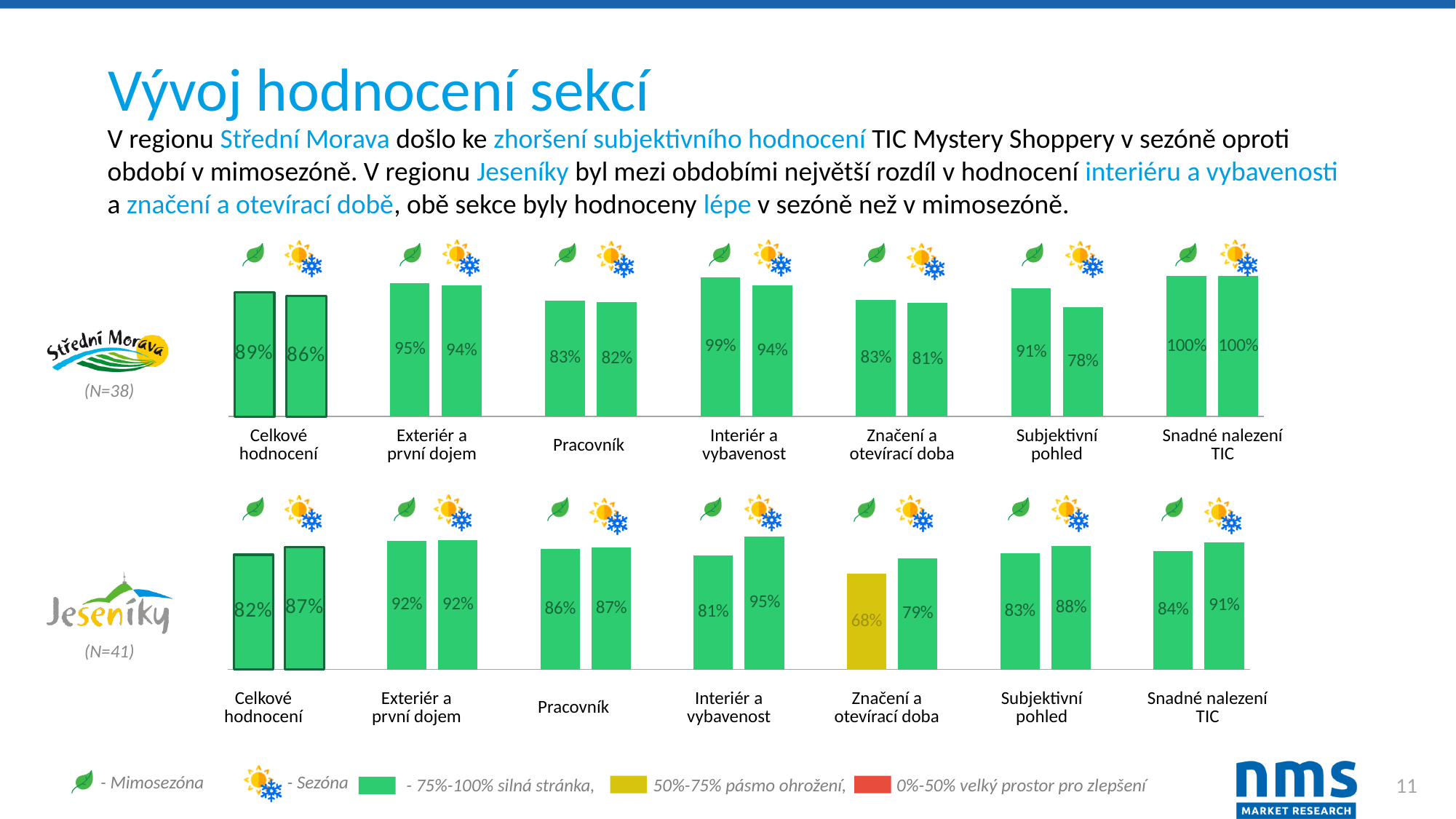
How many categories are shown in the Střední Morava chart? 7 What type of chart is used for the Jeseníky region? bar chart In the Jeseníky chart, what is the difference between the Sezóna and Mimosezóna values for Interiér a vybavenost? 14% In the Jeseníky chart, which category has the highest Sezóna value? Interiér a vybavenost In the Jeseníky chart, what is the Sezóna value for Snadné nalezení TIC? 91% In the Jeseníky chart, which bar is coloured yellow instead of green? Mimosezóna for Značení a otevírací doba In the Střední Morava chart, what is the Mimosezóna value for Interiér a vybavenost? 99% In the Střední Morava chart, what is the Sezóna value for Subjektivní pohled? 78% In the Jeseníky chart, what is the Mimosezóna value for Značení a otevírací doba? 68% In the Střední Morava chart, which category has the lowest Sezóna value? Subjektivní pohled In the Střední Morava chart, what is the difference between the Mimosezóna and Sezóna values for Subjektivní pohled? 13% In the Jeseníky chart, is the Sezóna value for Celkové hodnocení larger or smaller than the Mimosezóna value? larger